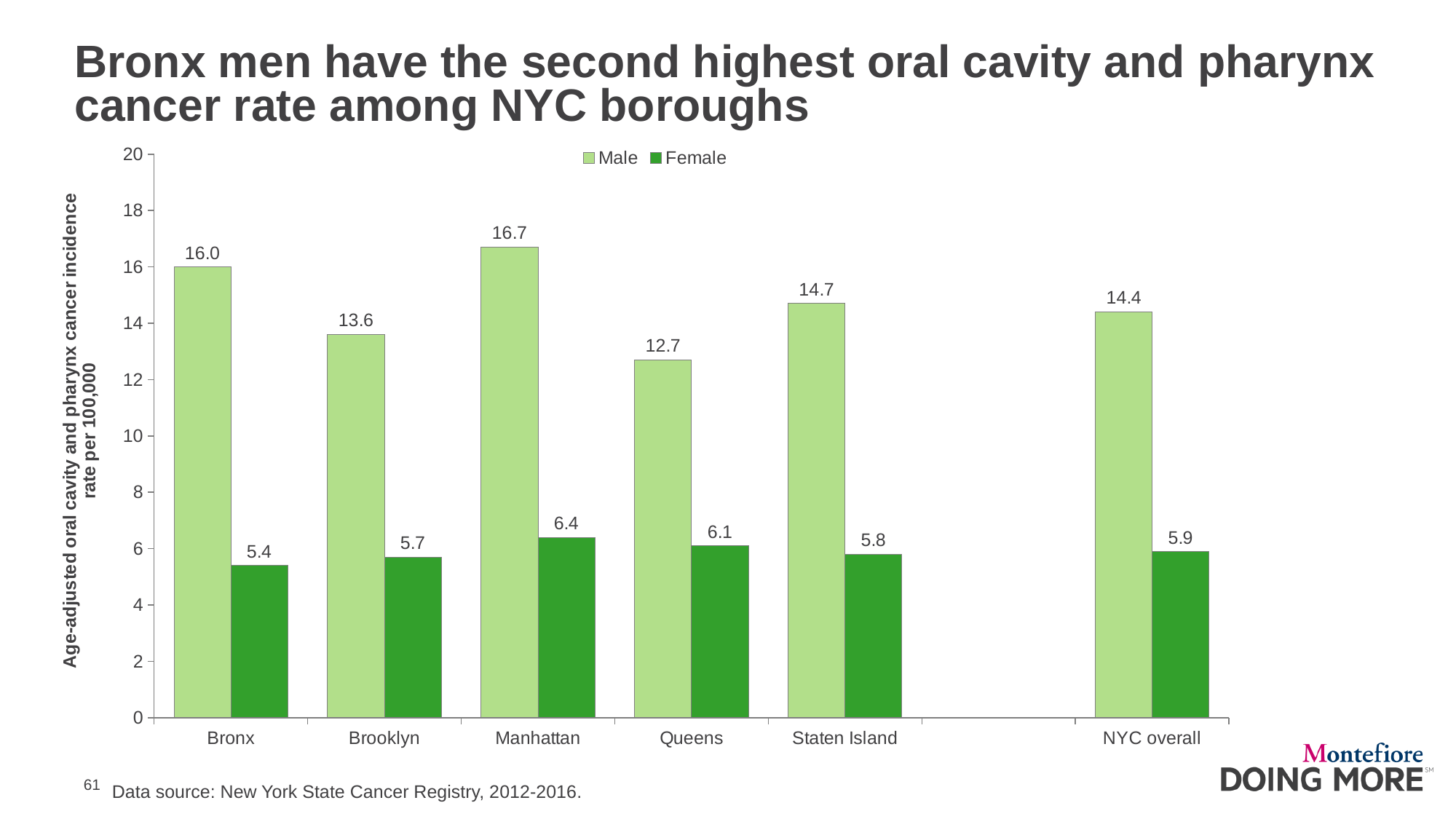
What is the Female oral cavity and pharynx cancer incidence rate for Manhattan? 6.4 Is the Male rate for Staten Island higher or lower than the Male rate for Brooklyn? Higher How many series does the legend list? 2 Which category has the lowest Male rate? Queens What is the difference between the Male and Female rates in the Bronx? 10.6 What is the Male rate for NYC overall? 14.4 What is the Male oral cavity and pharynx cancer incidence rate for the Bronx? 16.0 How many categories are shown on the x axis? 6 Which borough has the highest Male oral cavity and pharynx cancer incidence rate? Manhattan What is the label of the vertical axis? Age-adjusted oral cavity and pharynx cancer incidence rate per 100,000 What kind of chart is shown on the slide? Bar chart Which category has the lowest Female rate? Bronx